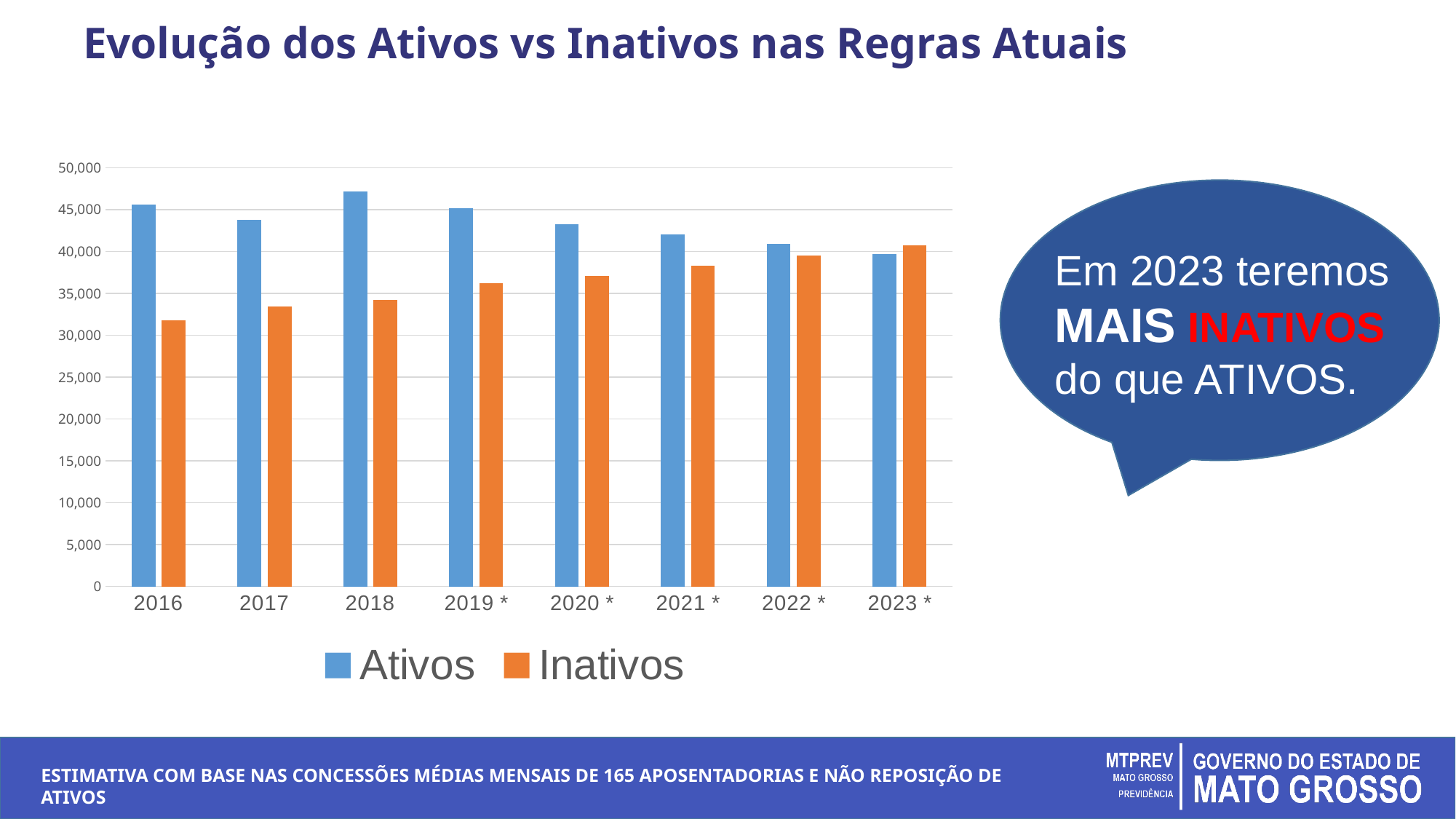
In which year is the Inativos bar lowest? 2016 In which year is the Ativos bar lowest? 2023 * In which year is the Inativos bar highest? 2023 * What kind of chart is shown on the slide? bar chart In which year is the Ativos bar highest? 2018 Do the Inativos values rise or fall from 2016 to 2023? rise Is the Inativos value for 2016 greater or less than 30,000? greater How many years are shown on the x axis? 8 How many series does the legend list? 2 Which series is shown in orange in the legend? Inativos Is the Ativos value for 2017 greater or less than 45,000? less Is the Inativos value for 2020 greater or less than 35,000? greater